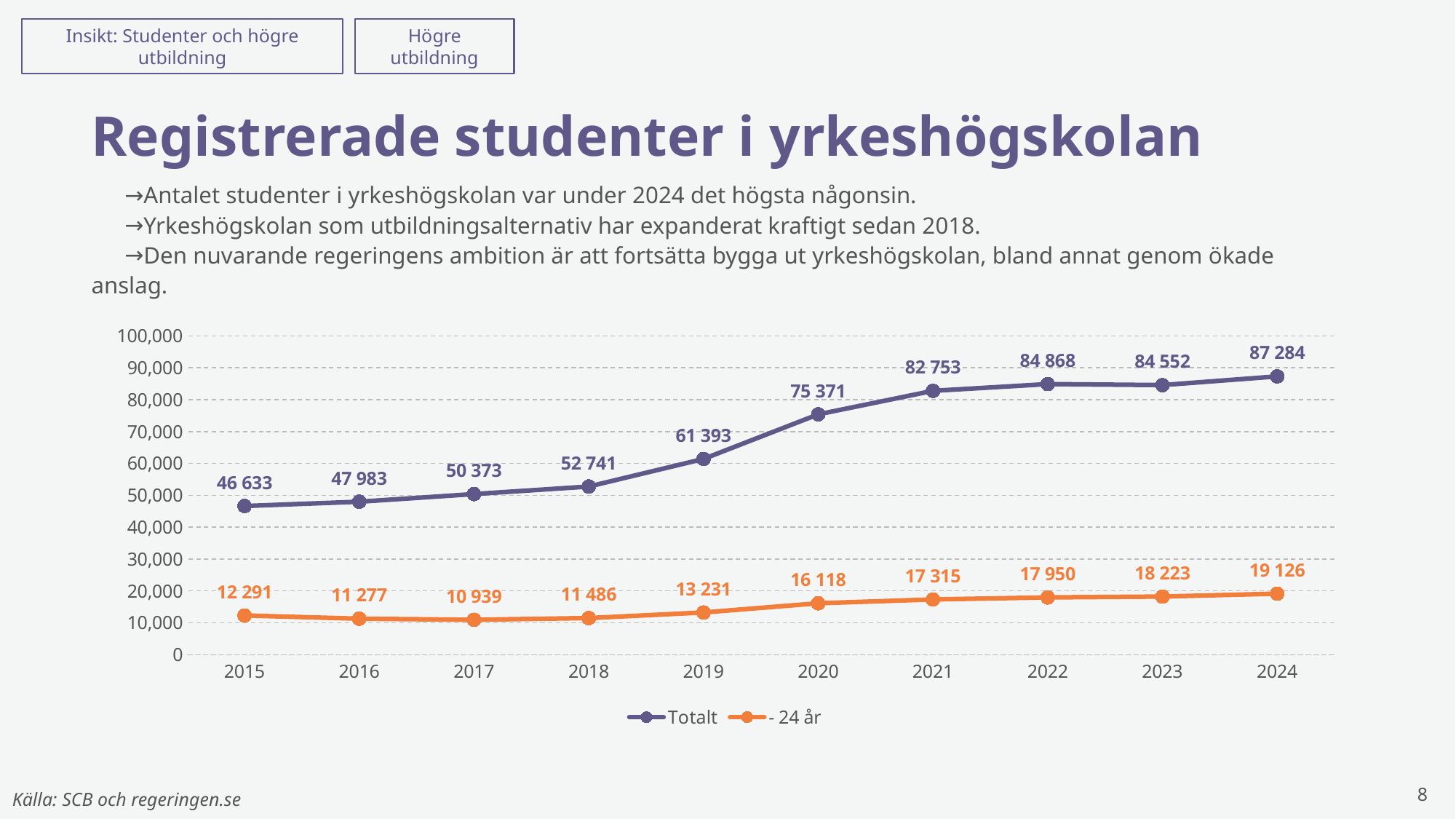
Which is larger, Totalt in 2022 or Totalt in 2023? 2022 Is the value for Totalt in 2020 greater or less than 70,000? greater In which year is the Totalt series at its highest? 2024 How many series does the legend list? 2 What is the value of the '- 24 år' series in 2017? 10 939 What type of chart is shown on the slide? line chart By how much did Totalt change from 2022 to 2023? 316 Does the Totalt series generally rise or fall from 2015 to 2024? rise In which year is the '- 24 år' series at its lowest? 2017 What is the value of Totalt in 2020? 75 371 What is the difference between Totalt and '- 24 år' in 2024? 68 158 How many years are plotted along the x axis? 10